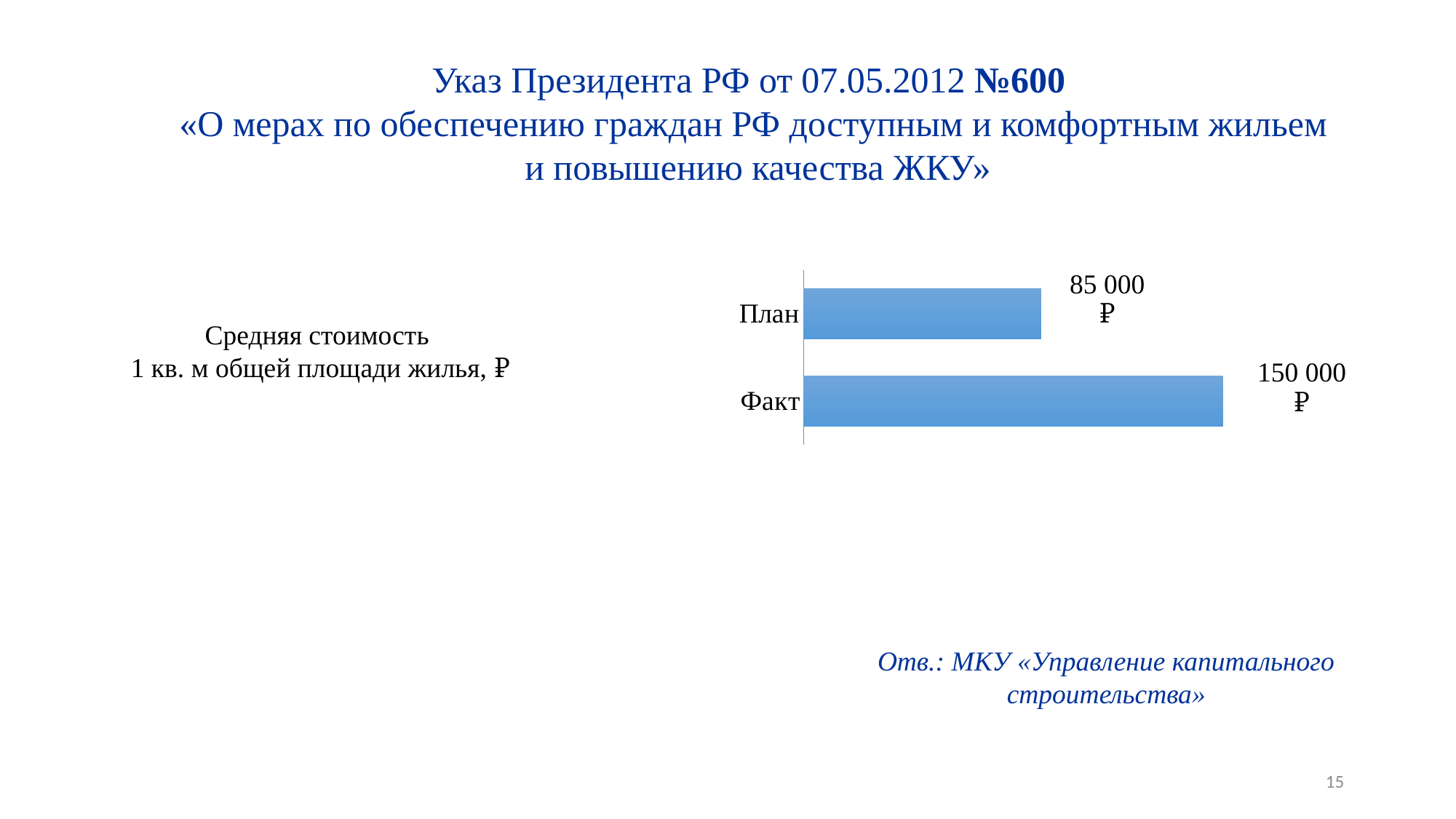
What is the difference between the Факт and План values? 65 000 ₽ Which category has the lower value? План What quantity does the chart show, according to the text to its left? Средняя стоимость 1 кв. м общей площади жилья, ₽ How many categories are shown in the chart? 2 What colour are the bars in the chart? blue What kind of chart is shown on the slide? bar chart What is the value for Факт (Fact)? 150 000 ₽ What is the value for План (Plan)? 85 000 ₽ Which category has the higher value, План or Факт? Факт Is the value for Факт larger or smaller than the value for План? larger